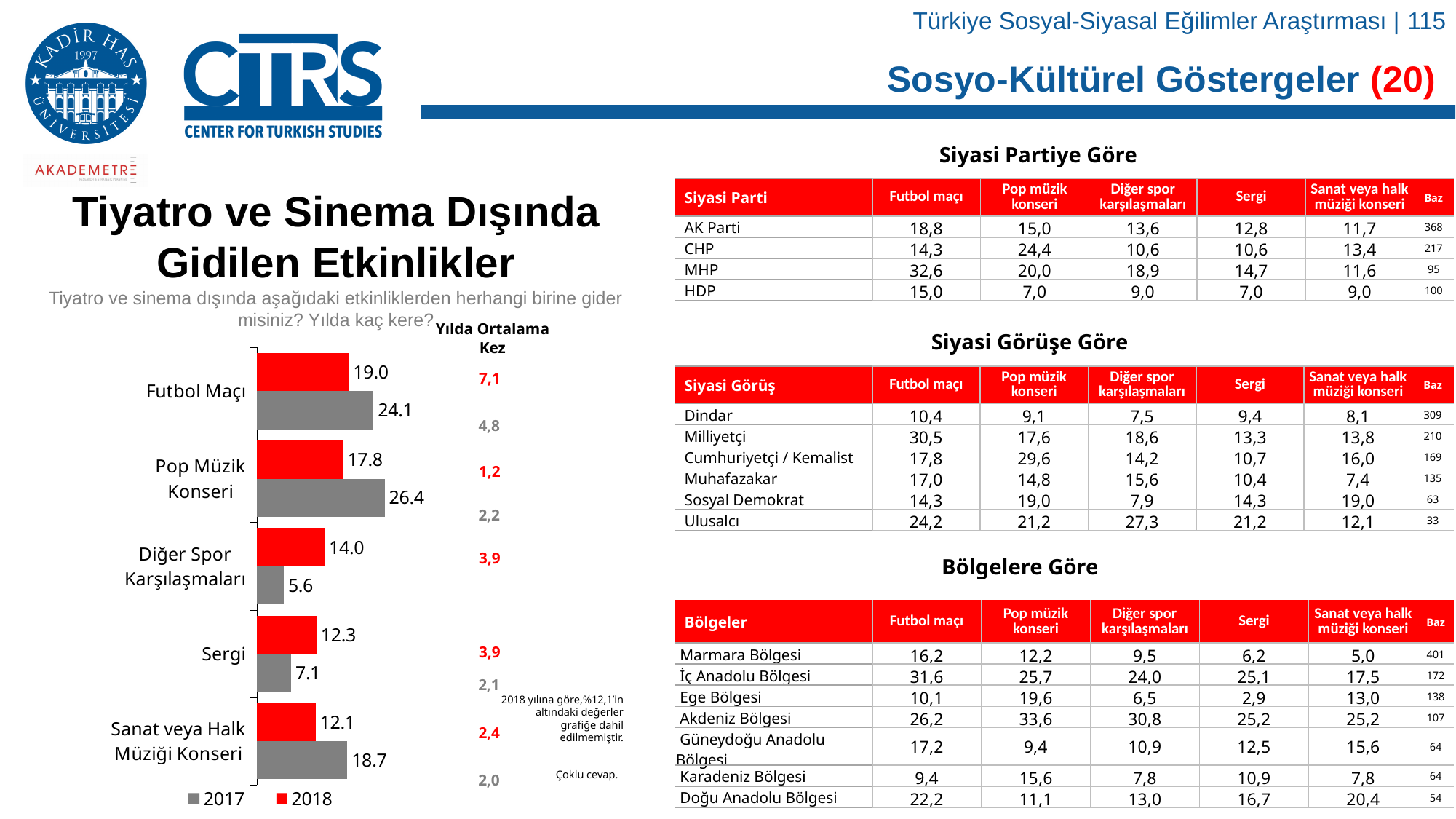
What is the 2017 value for Pop Müzik Konseri in the bar chart? 26.4 What is the difference between the 2017 and 2018 values for Pop Müzik Konseri? 8.6 How many categories are shown in the bar chart? 5 How many series does the chart legend list? 2 Which category has the highest 2018 value in the bar chart? Futbol Maçı Which category has the lowest 2017 value in the bar chart? Diğer Spor Karşılaşmaları What is the 2018 value for Futbol Maçı in the bar chart? 19.0 What type of chart is shown on the slide? bar chart Which colour represents the 2018 series in the bar chart? red What is the difference between the 2017 and 2018 values for Sanat veya Halk Müziği Konseri? 6.6 What is the 2017 value for Diğer Spor Karşılaşmaları in the bar chart? 5.6 For Sergi, which year has the larger value, 2017 or 2018? 2018